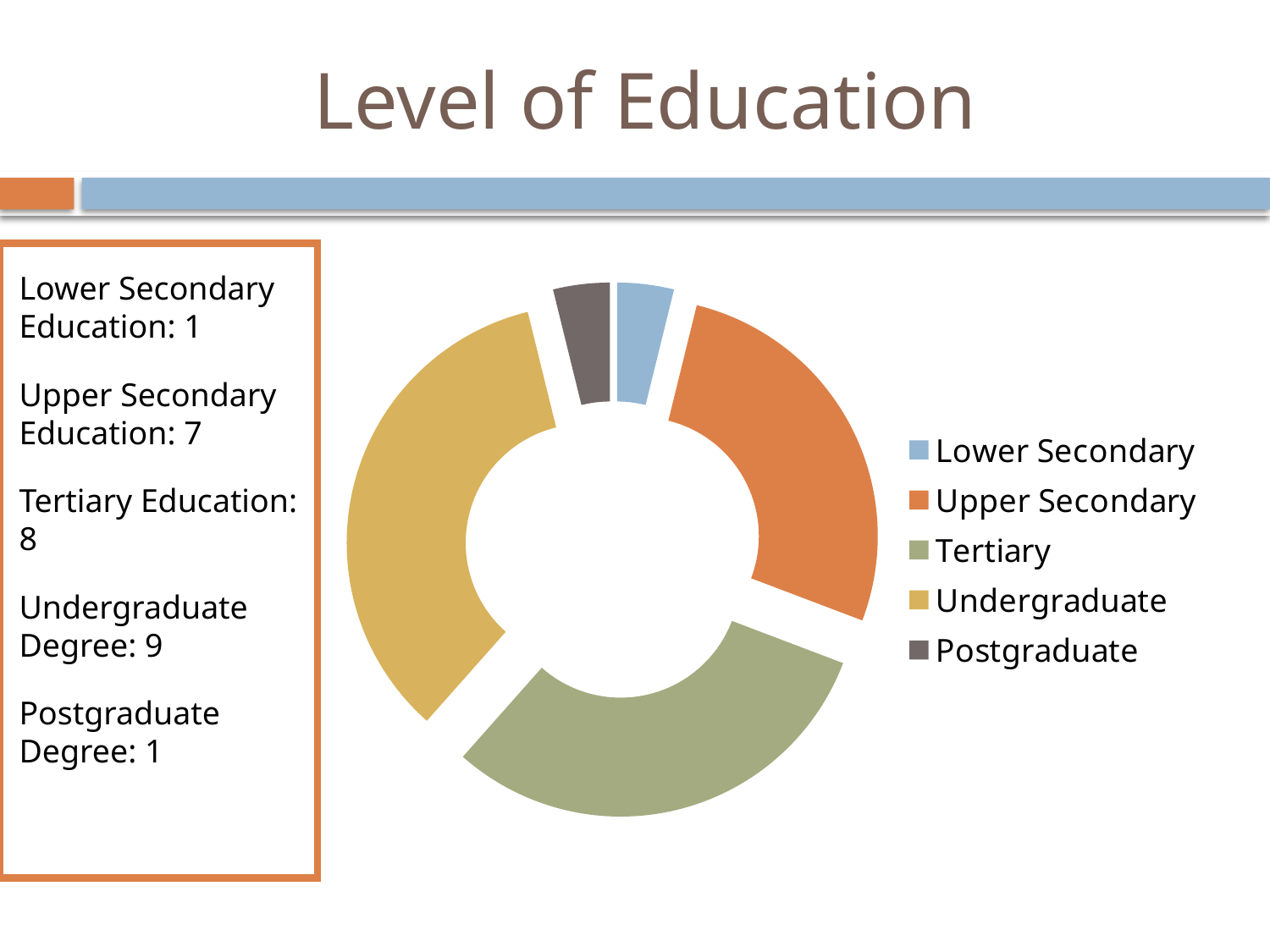
What is the difference between the Undergraduate and Upper Secondary values? 2 Which is larger, the value for Upper Secondary or the value for Lower Secondary? Upper Secondary What is the total of all the values shown? 26 What kind of chart is shown on the slide? doughnut chart What is the value for Postgraduate Degree? 1 What is the title of the slide? Level of Education Which level of education has the highest value? Undergraduate What is the value for Tertiary Education? 8 What is the value for Upper Secondary Education? 7 What is the difference between the Tertiary and Lower Secondary values? 7 How many categories does the chart show? 5 What is the value for Undergraduate Degree? 9